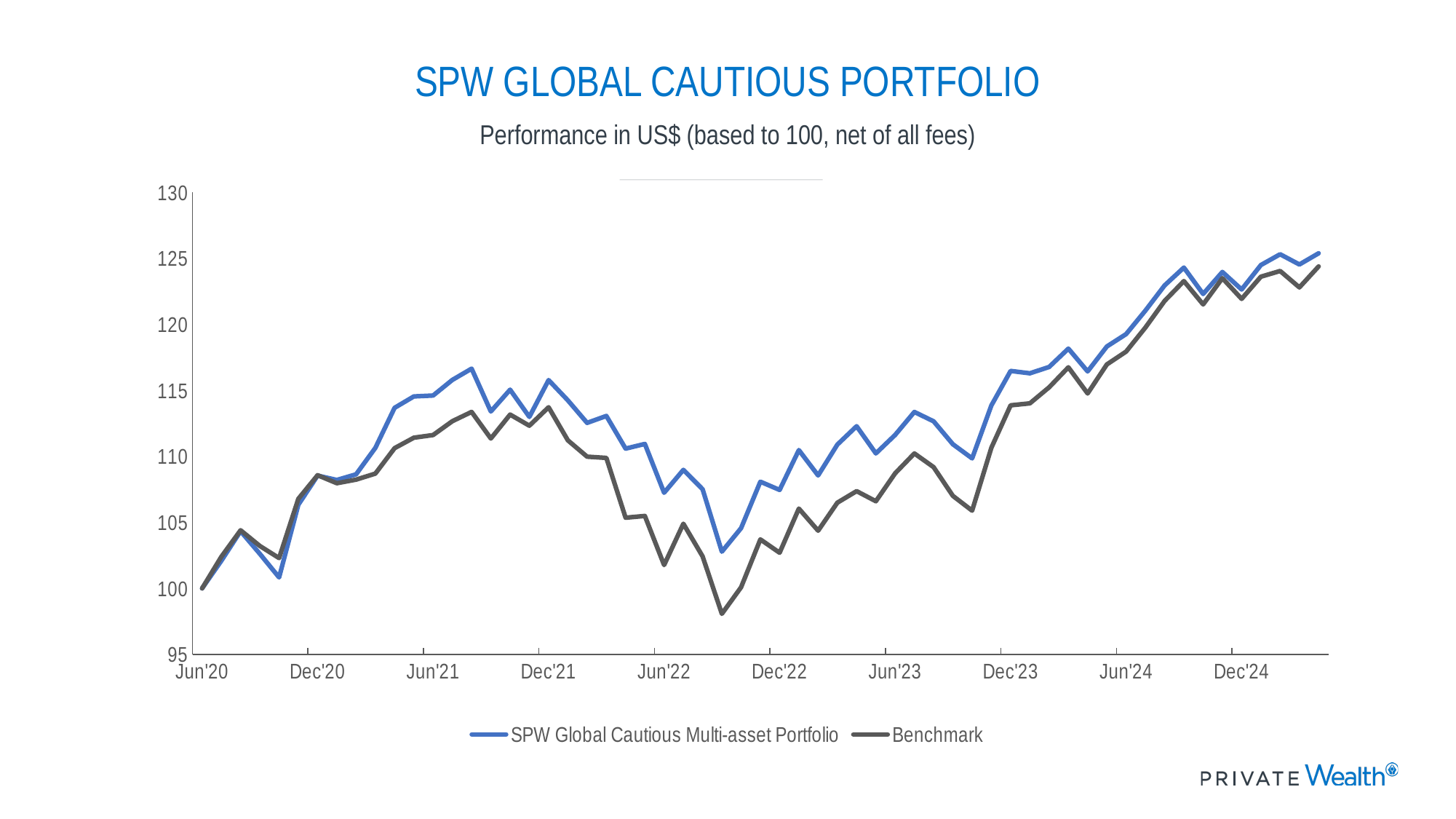
What are the two series named in the legend? SPW Global Cautious Multi-asset Portfolio and Benchmark What kind of chart is shown on the slide? line chart How many series does the legend list? 2 Is the lowest point of the Benchmark line greater or less than 100? less What is the title of the chart? SPW GLOBAL CAUTIOUS PORTFOLIO Is the value of the SPW Global Cautious Multi-asset Portfolio at Dec'24 greater or less than 120? greater At Jun'22, which series has the higher value, the SPW Global Cautious Multi-asset Portfolio or the Benchmark? SPW Global Cautious Multi-asset Portfolio Is the value of the Benchmark at Jun'23 greater or less than 105? greater Overall, do the values rise or fall from Jun'20 to the end of the chart? rise At what value do both series start in Jun'20? 100 Between Dec'21 and Jun'22, does the Benchmark line rise or fall? fall